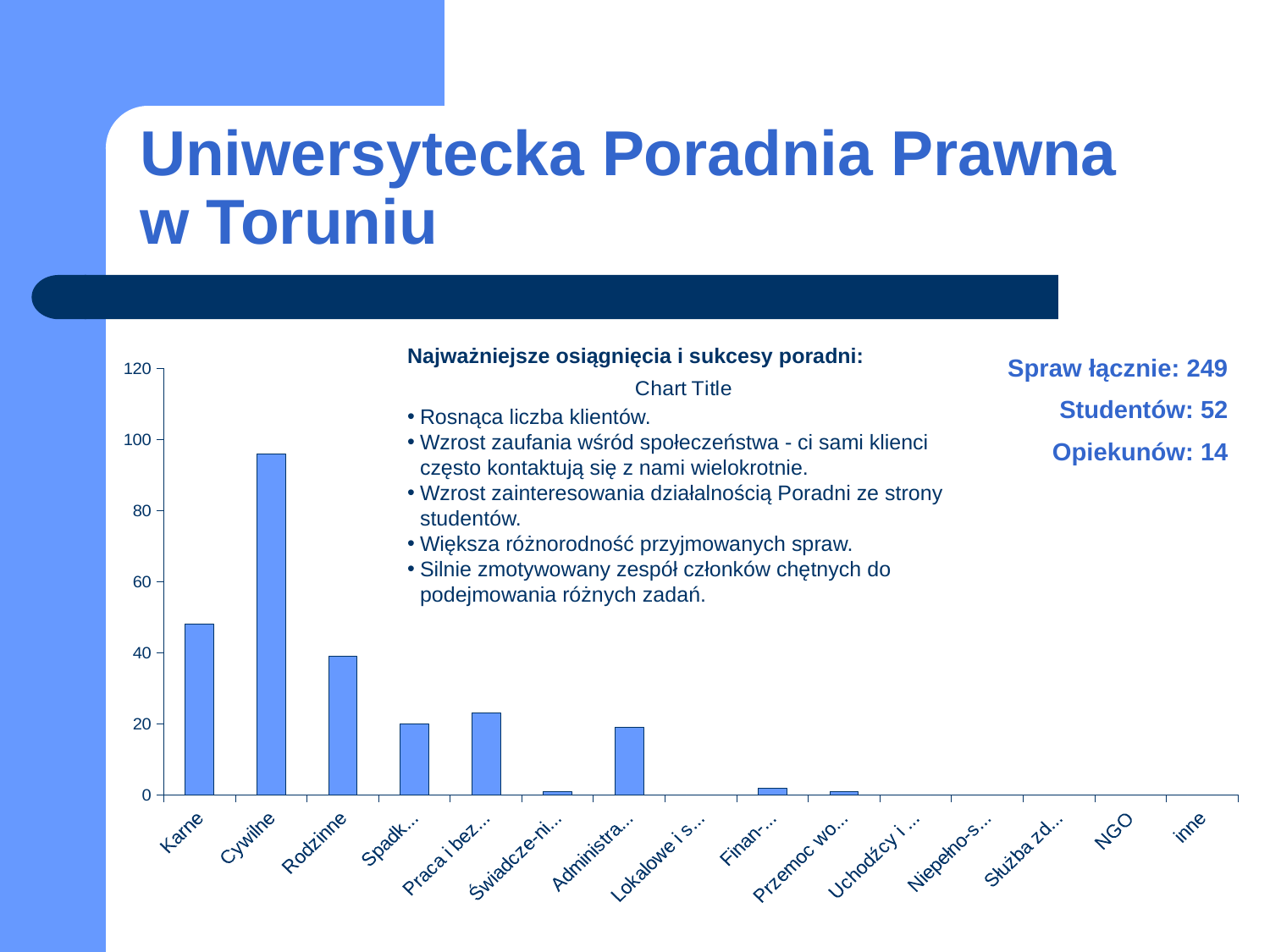
What is the highest value shown on the chart's vertical axis? 120 What kind of chart is shown on the slide? bar chart Which has the larger value, Rodzinne or NGO? Rodzinne Which has the larger value, Karne or Rodzinne? Karne Which category has the highest value in the chart? Cywilne Is the value for Karne greater or less than 40? greater Is the value for Cywilne greater or less than 80? greater Is the value for Cywilne greater or less than 100? less How many categories are shown on the x axis of the chart? 15 Which has the larger value, Cywilne or Karne? Cywilne